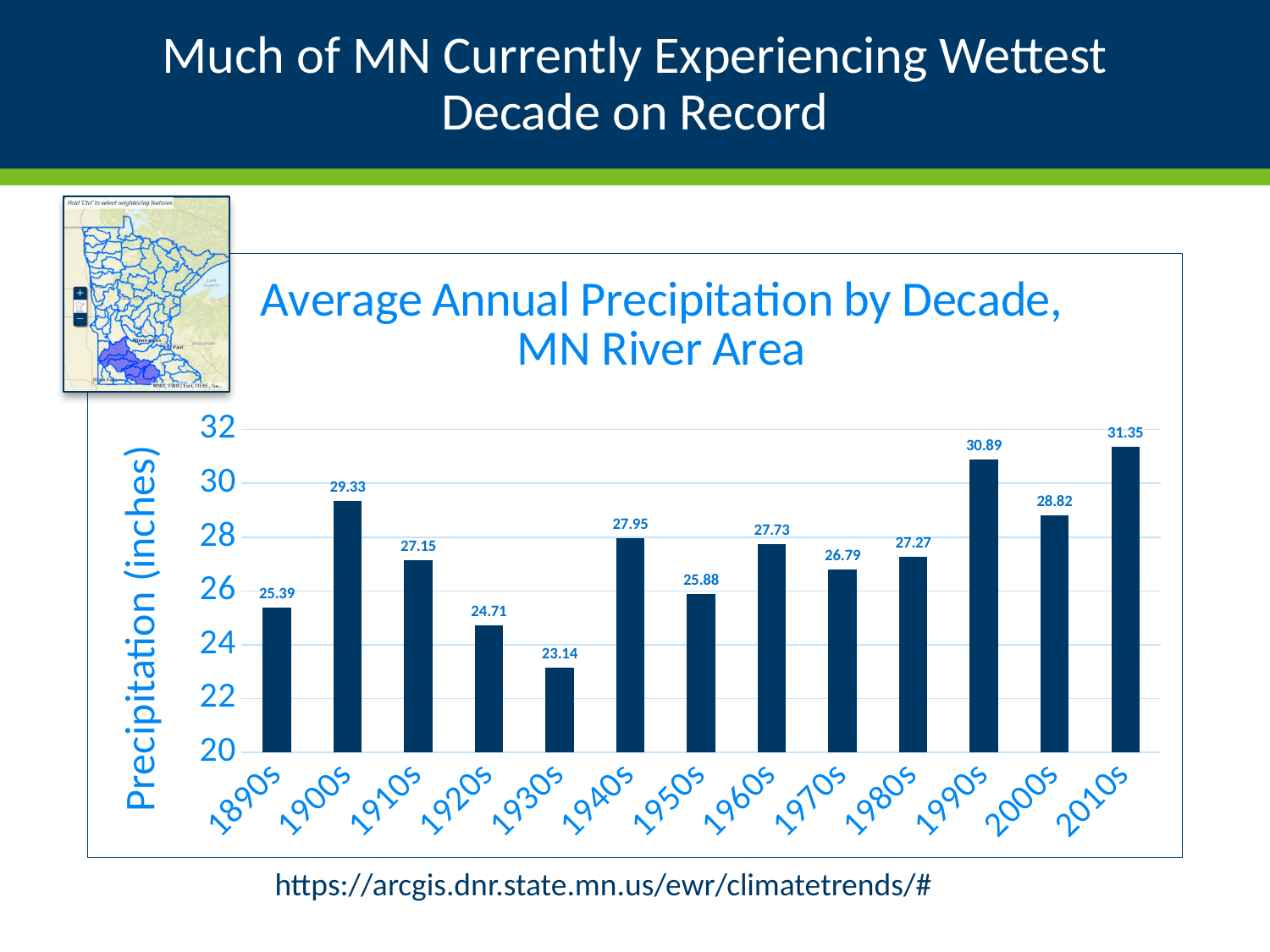
How many decades are shown on the chart? 13 What is the difference between the 1990s and 2000s values? 2.07 Is the value for the 1920s greater or less than 26? less Which decade has the lowest average annual precipitation? 1930s What is the average annual precipitation for the 2010s? 31.35 Which decade has a higher value, the 1940s or the 1960s? 1940s Which decade has the highest average annual precipitation? 2010s What is the value shown for the 1900s? 29.33 What is the average annual precipitation for the 1930s? 23.14 What kind of chart is shown on the slide? bar chart What is the difference between the 2010s and 1930s values? 8.21 What is the title of the chart? Average Annual Precipitation by Decade, MN River Area